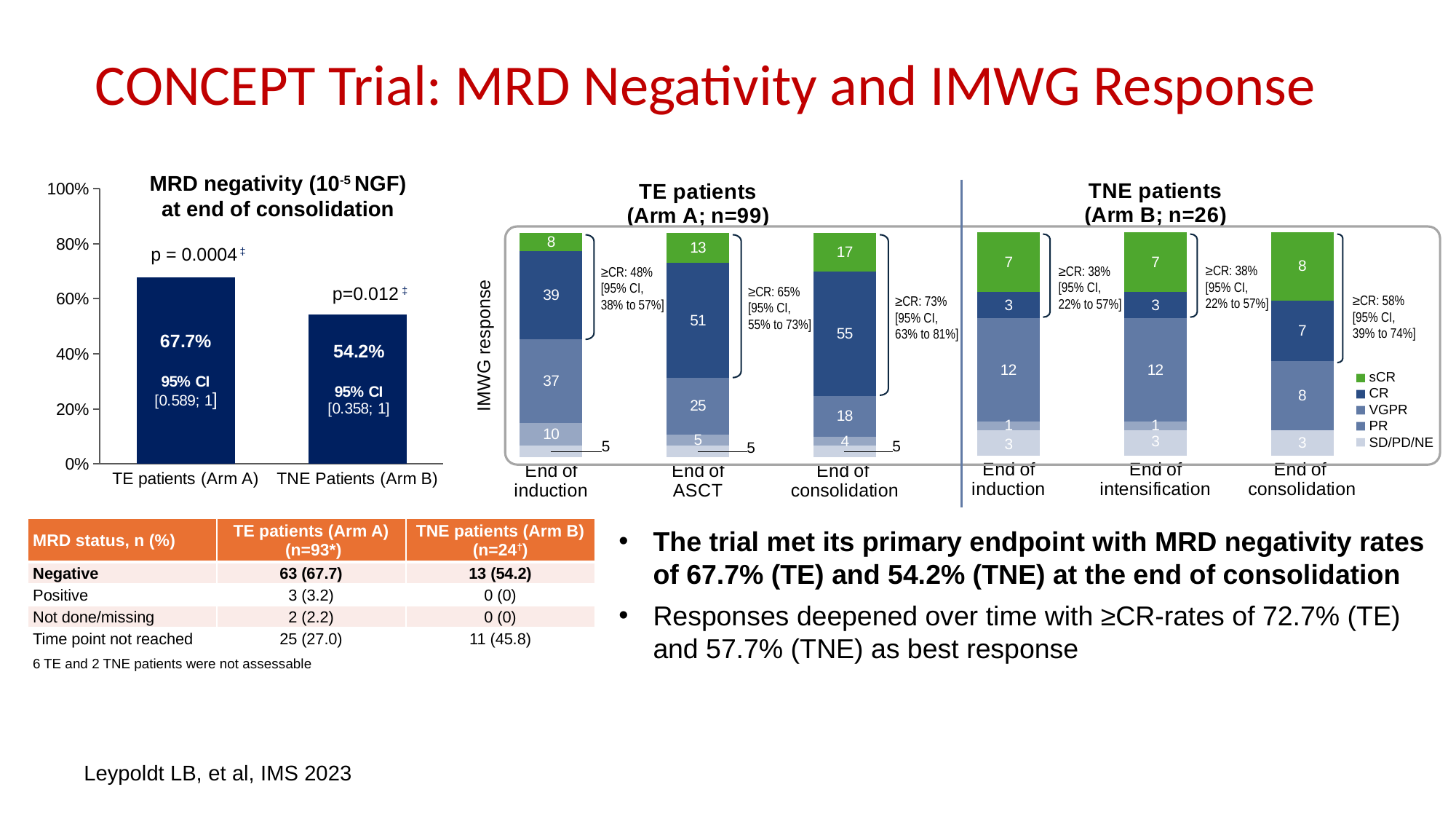
In the TNE patients (Arm B) IMWG response chart, how many patients had sCR at end of consolidation? 8 In the MRD negativity chart, what is the difference between the TE and TNE MRD negativity rates? 13.5 percentage points In the TE patients (Arm A) IMWG response chart, does the number of CR patients rise or fall from end of induction to end of consolidation? Rise In the MRD negativity chart, what is the MRD negativity rate for TNE Patients (Arm B)? 54.2% In the TNE patients (Arm B) IMWG response chart, how many patients had VGPR at end of induction? 12 In the MRD negativity chart, is the value for TE patients (Arm A) greater or less than 60%? greater In the MRD negativity chart, what is the MRD negativity rate for TE patients (Arm A)? 67.7% In the MRD negativity chart, which arm has the higher MRD negativity rate? TE patients (Arm A) What kind of chart is the MRD negativity chart? Bar chart In the TE patients (Arm A) IMWG response chart, what is the total of the stacked bar at end of ASCT? 99 How many series does the legend of the IMWG response charts list? 5 In the TE patients (Arm A) IMWG response chart, how many patients had CR at end of consolidation? 55